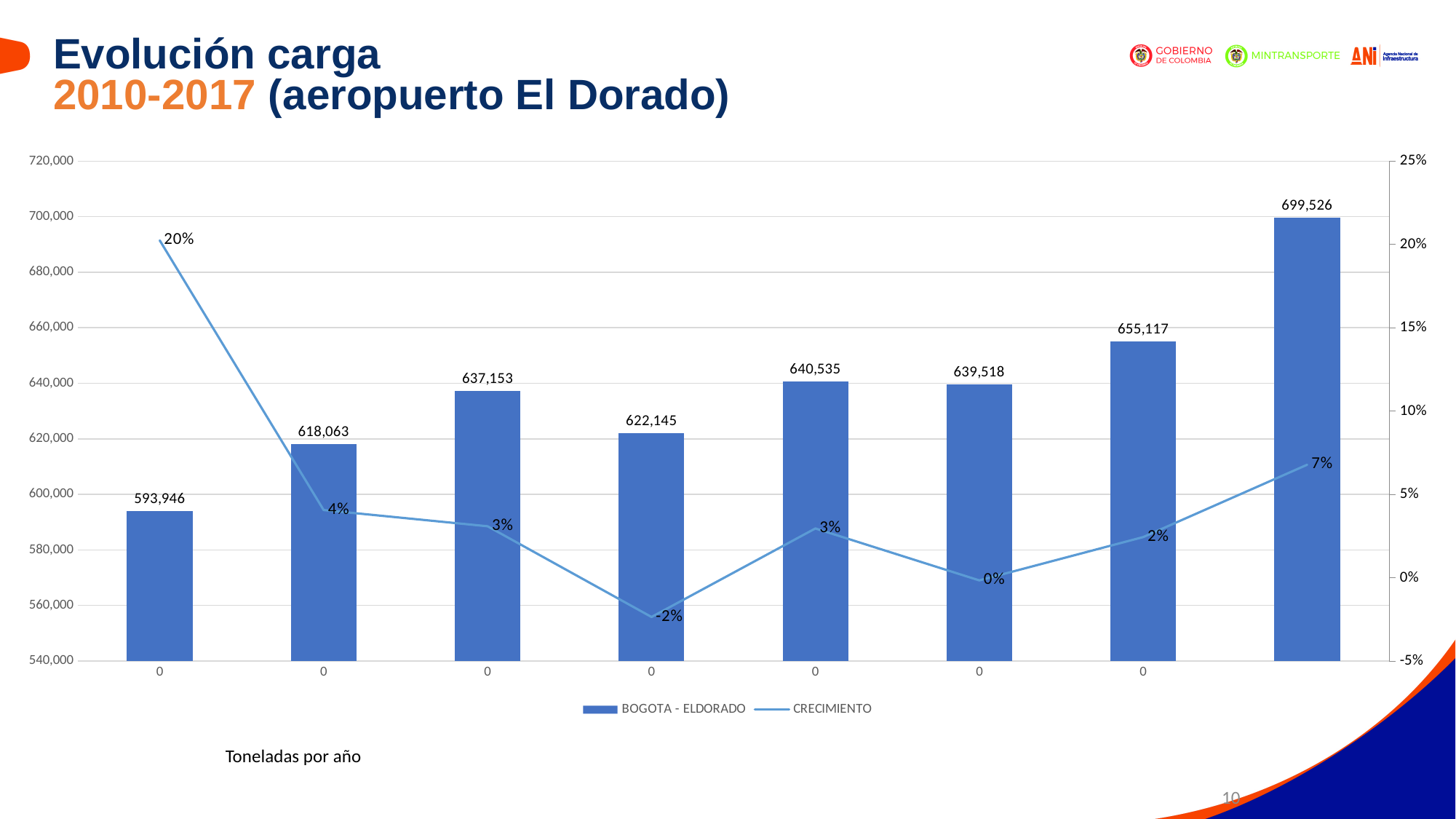
What is the value of the shortest bar (BOGOTA - ELDORADO) on the chart? 593,946 What is the value of the tallest bar (BOGOTA - ELDORADO) on the chart? 699,526 What are the two series names listed in the legend? BOGOTA - ELDORADO and CRECIMIENTO What is the CRECIMIENTO value at the first point on the left? 20% What is the lowest CRECIMIENTO value shown on the line? -2% What is the difference between the tallest bar (699,526) and the shortest bar (593,946)? 105,580 How many bars are plotted on the chart? 8 How many series does the legend list? 2 What kind of chart is shown on the slide? combined bar and line chart What is the value of the third bar from the left? 637,153 Which is larger, the third bar (637,153) or the fourth bar (622,145)? the third bar (637,153) Is the value of the first bar on the left greater or less than 600,000? less